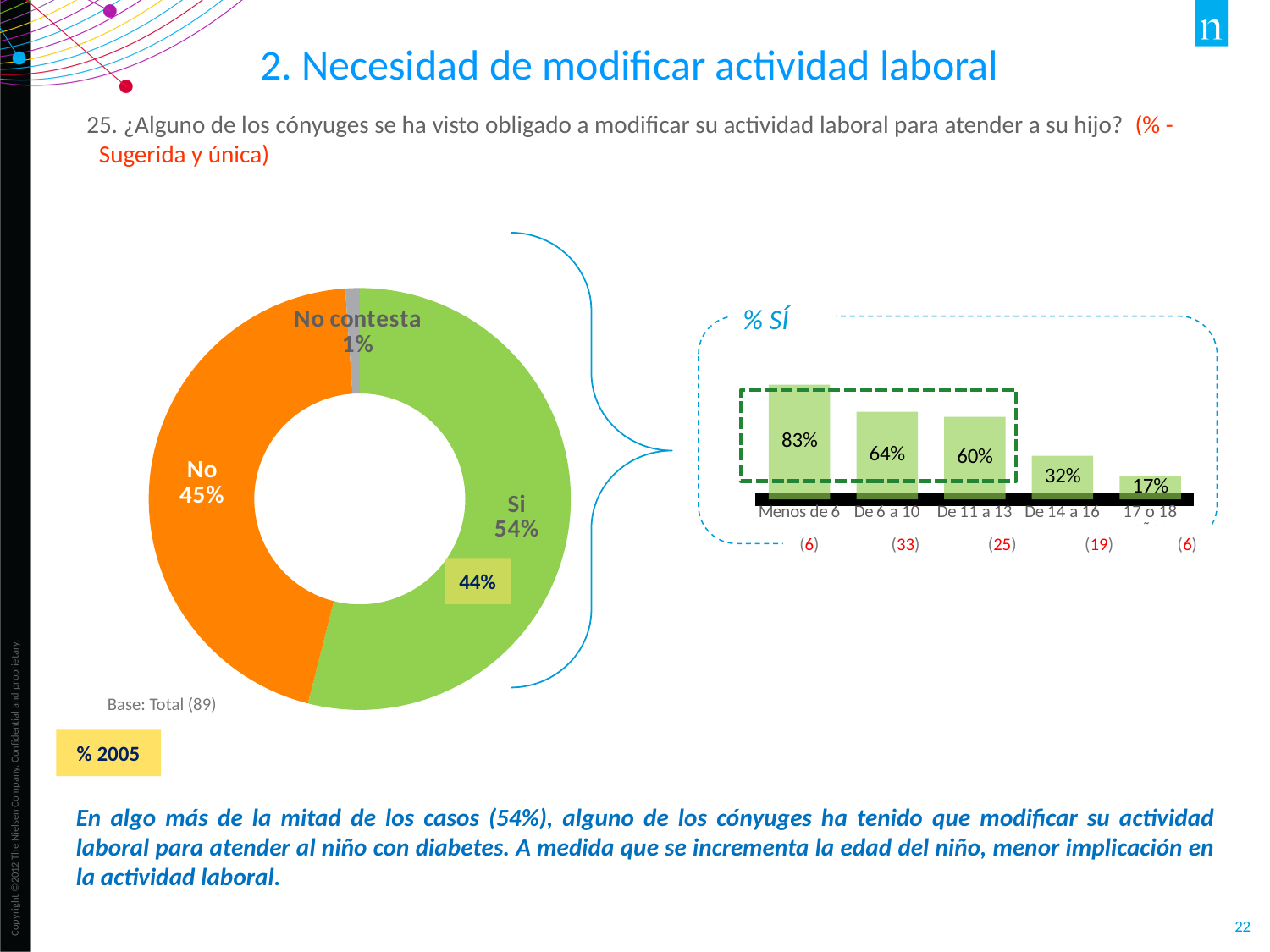
In the donut chart on the left, what is the difference in percentage points between "Si" and "No"? 9 In the "% SÍ" bar chart on the right, how many age groups are shown? 5 In the "% SÍ" bar chart on the right, what is the difference in percentage points between "De 6 a 10" and "De 11 a 13"? 4 In the "% SÍ" bar chart on the right, do the values rise or fall as the age group increases? fall In the donut chart on the left, what percentage answered "Si"? 54% In the "% SÍ" bar chart on the right, what is the value for "Menos de 6"? 83% In the donut chart on the left, which category has the smallest share? No contesta In the donut chart on the left, what percentage is "No contesta"? 1% In the donut chart on the left, which category has the largest share? Si In the "% SÍ" bar chart on the right, which age group has the lowest value? 17 o 18 años In the donut chart on the left, what percentage answered "No"? 45% In the "% SÍ" bar chart on the right, what is the value for "De 14 a 16"? 32%